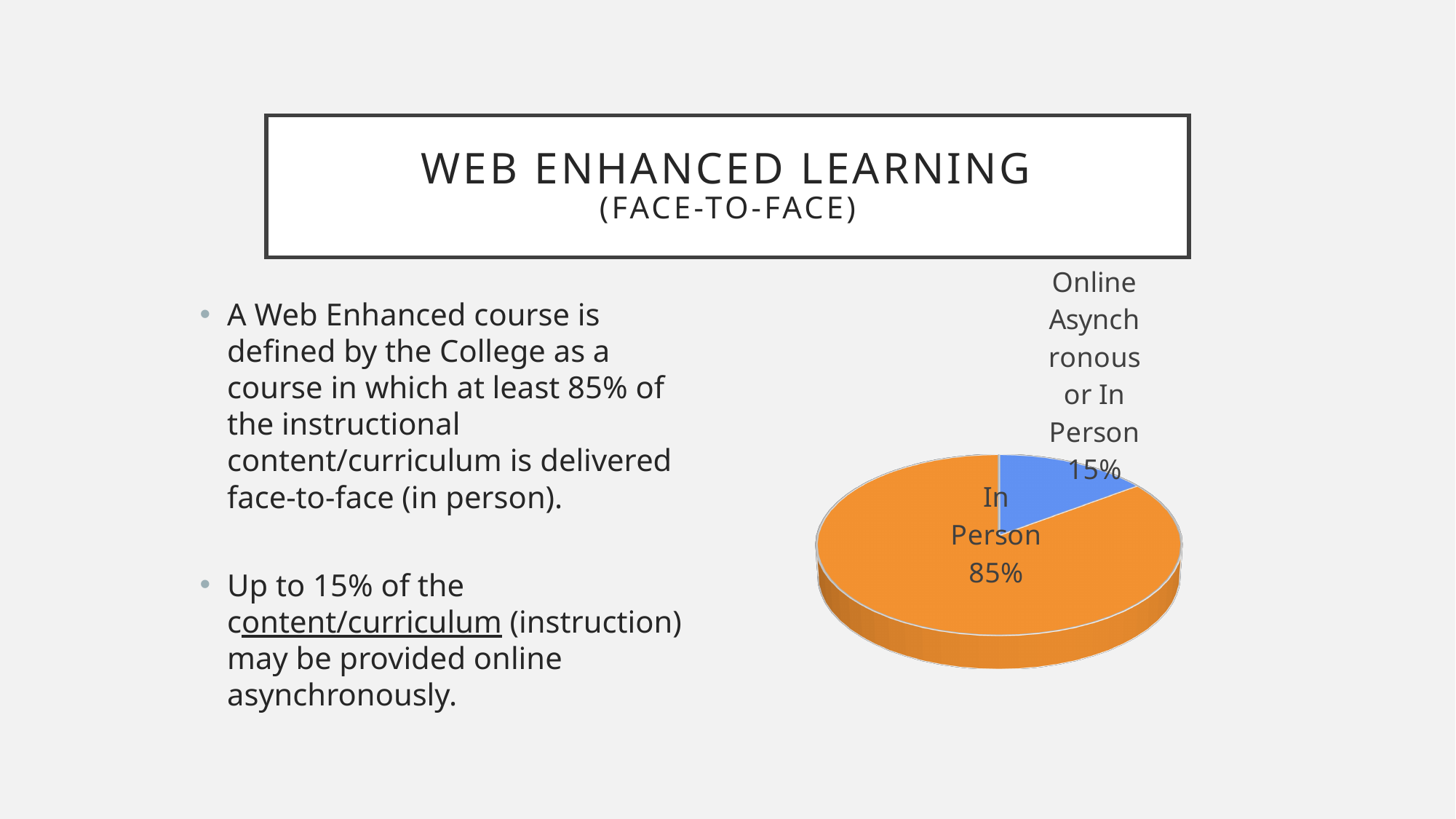
What colour is the Online Asynchronous or In Person slice of the pie? Blue What share of the pie does the In Person slice represent? 85% Which is larger: the In Person slice or the Online Asynchronous or In Person slice? In Person What is the total of the two slices shown in the pie chart? 100% How many slices does the pie chart have? 2 Which slice of the pie is the largest? In Person What is the difference in percentage points between the In Person slice and the Online Asynchronous or In Person slice? 70% What kind of chart is shown on the slide? Pie chart What share of the pie does the Online Asynchronous or In Person slice represent? 15% What colour is the In Person slice of the pie? Orange Which slice of the pie is the smallest? Online Asynchronous or In Person